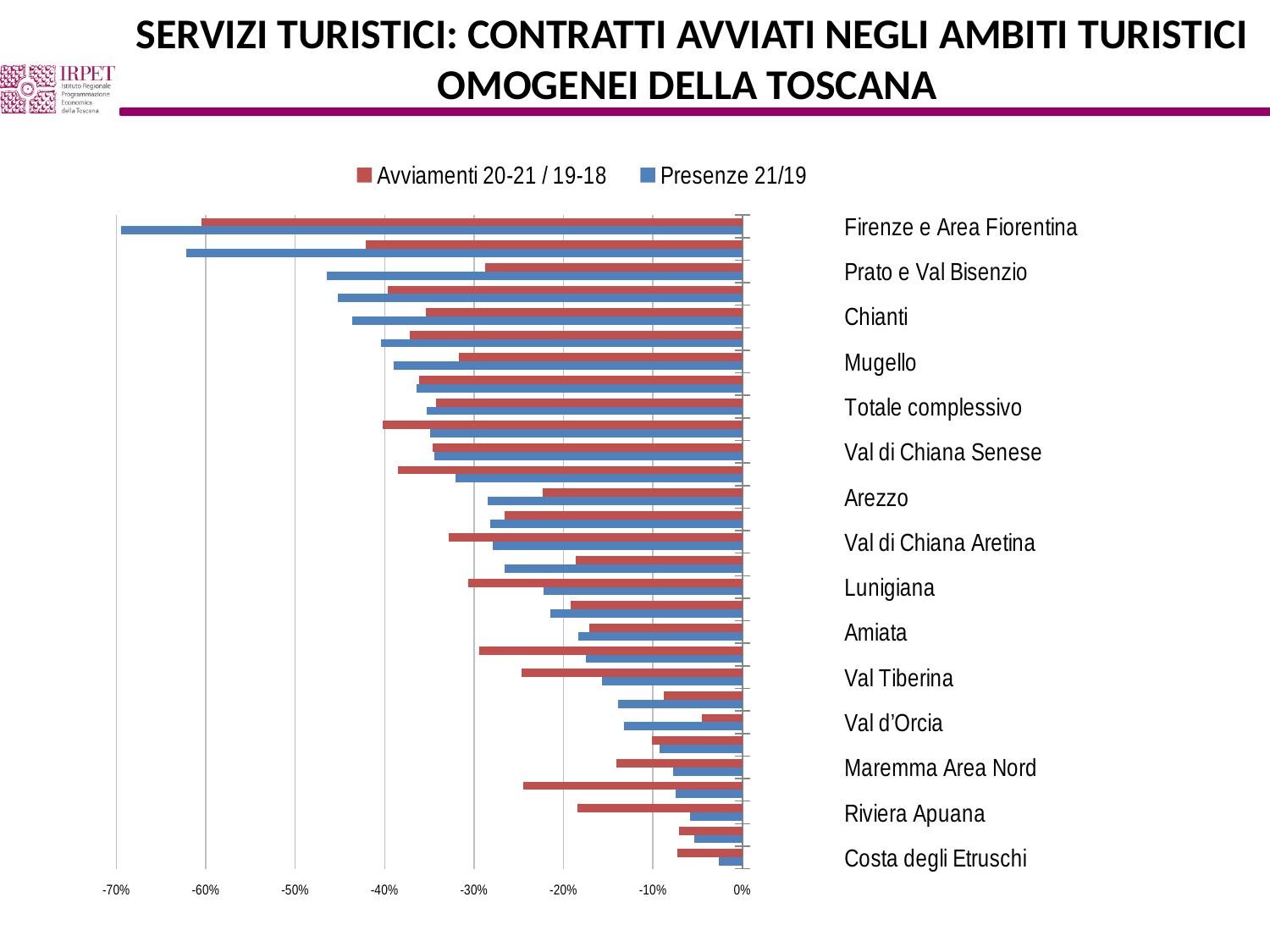
What kind of chart is shown on the slide? bar chart Moving from the top of the chart to the bottom, do the Presenze 21/19 values generally become more negative or less negative? less negative For Firenze e Area Fiorentina, which series shows the larger decline, Avviamenti 20-21 / 19-18 or Presenze 21/19? Presenze 21/19 What is the leftmost value shown on the horizontal axis? -70% How many series does the legend list? 2 Which colour represents the series Presenze 21/19? blue Is the Presenze 21/19 value for Firenze e Area Fiorentina greater or less than -60%? less Which category has the Presenze 21/19 value closest to 0%? Costa degli Etruschi Is the Avviamenti 20-21 / 19-18 value for Costa degli Etruschi greater or less than -10%? greater Which category has the lowest (most negative) Presenze 21/19 value? Firenze e Area Fiorentina What are the two series named in the legend? Avviamenti 20-21 / 19-18 and Presenze 21/19 How many category labels are listed to the right of the chart? 15